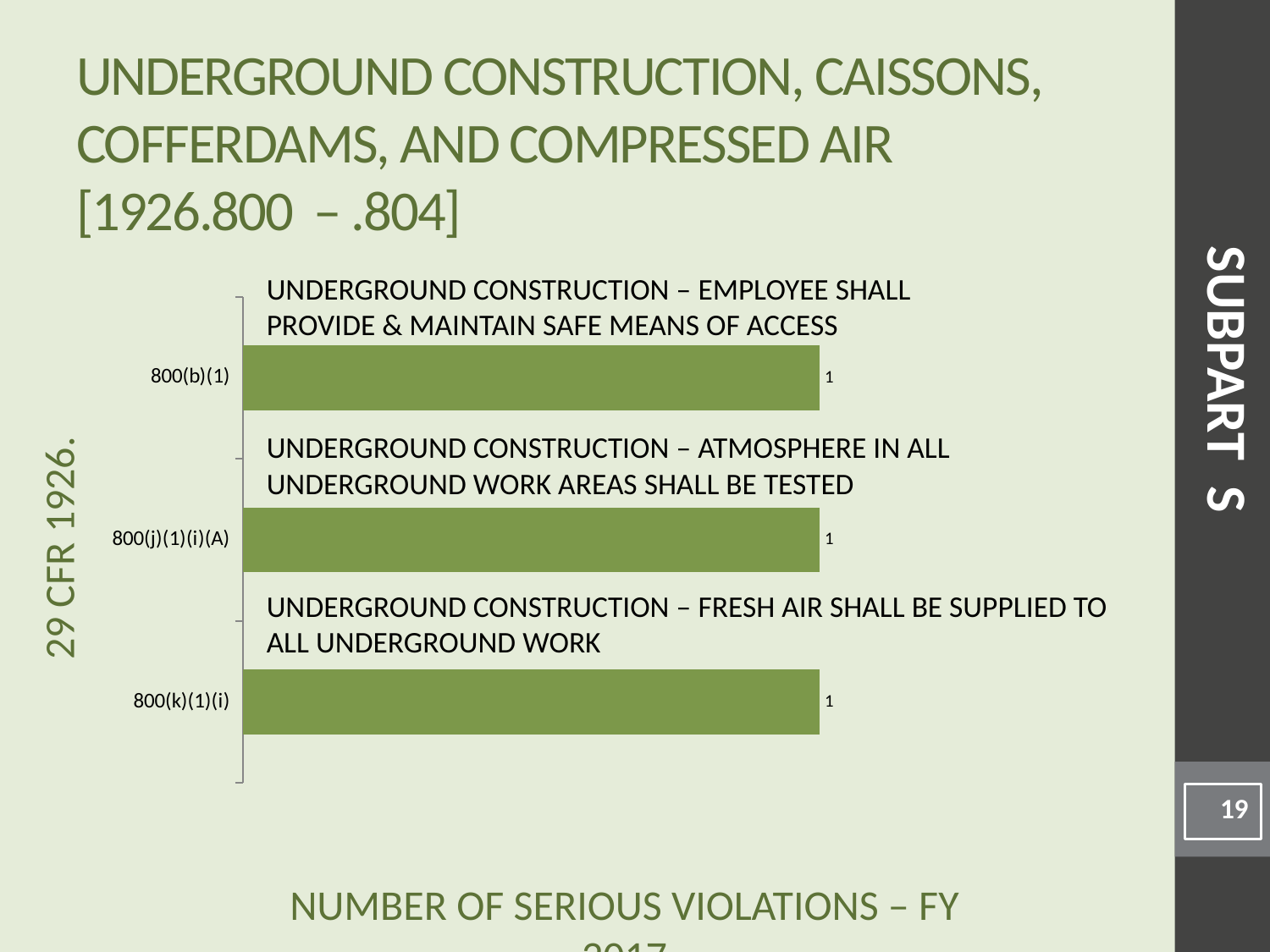
What is the number of serious violations for 800(j)(1)(i)(A)? 1 Do all three bars in the chart have the same value? Yes What is the difference between the values for 800(b)(1) and 800(k)(1)(i)? 0 What kind of chart is shown on the slide? Bar chart What is the number of serious violations for 800(b)(1)? 1 How many categories are plotted in the chart? 3 Which standard is described as 'FRESH AIR SHALL BE SUPPLIED TO ALL UNDERGROUND WORK'? 800(k)(1)(i) What is the number of serious violations for 800(k)(1)(i)? 1 What is the label on the vertical axis of the chart? 29 CFR 1926.